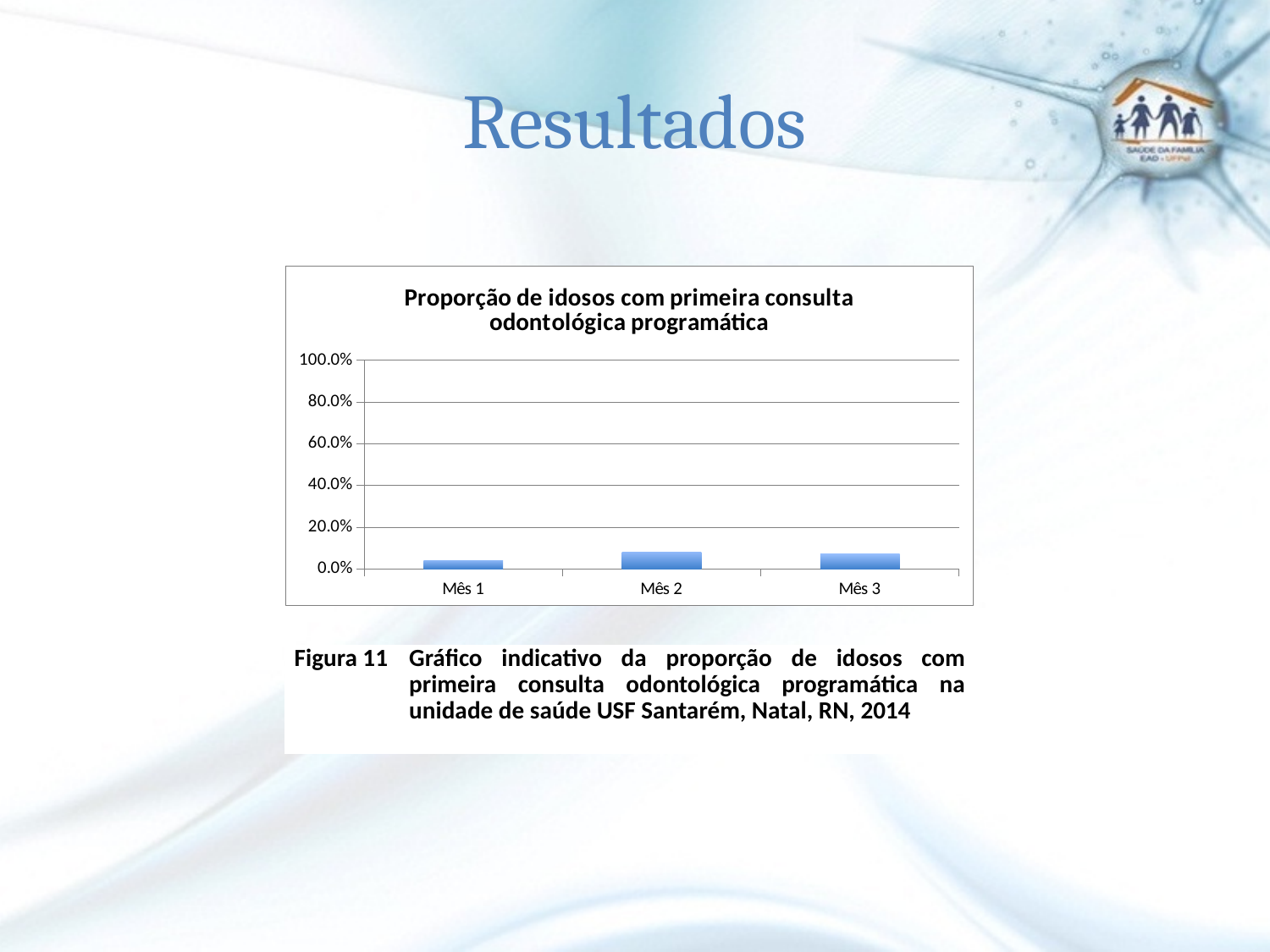
Is the value for Mês 3 greater or less than 40.0%? less What is the title of the chart? Proporção de idosos com primeira consulta odontológica programática Is the value for Mês 2 greater or less than 20.0%? less Which category has the lowest value in the chart? Mês 1 Which is larger, the value for Mês 1 or the value for Mês 2? Mês 2 How many categories are plotted on the x axis of the chart? 3 What kind of chart is shown on the slide? bar chart What is the highest value shown on the y axis of the chart? 100.0% Which is larger, the value for Mês 1 or the value for Mês 3? Mês 3 Is the value for Mês 1 greater or less than 20.0%? less